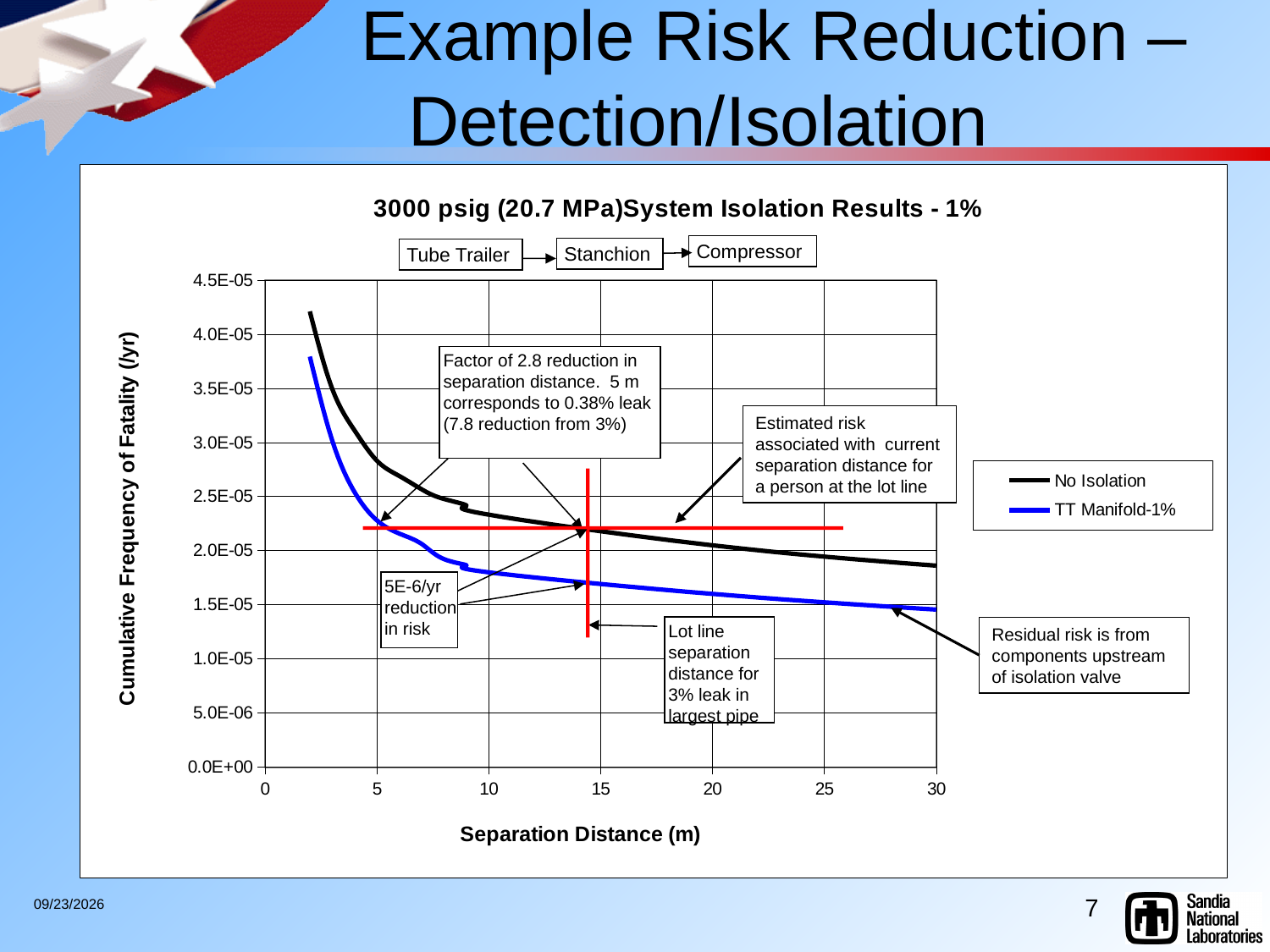
At a separation distance of 15 m, which series has the higher cumulative frequency of fatality, No Isolation or TT Manifold-1%? No Isolation Which series lies below the other across the whole plotted range? TT Manifold-1% How many series does the chart legend list? 2 What is the label of the x axis? Separation Distance (m) At a separation distance of 30 m, is the value for No Isolation greater or less than 2.0E-05? less At a separation distance of 30 m, is the value for TT Manifold-1% greater or less than 2.0E-05? less At a separation distance of 5 m, is the value for TT Manifold-1% greater or less than 2.0E-05? greater What kind of chart is shown on the slide? line chart Does the TT Manifold-1% curve rise or fall as separation distance increases? fall What is the title of the chart? 3000 psig (20.7 MPa)System Isolation Results - 1% Does the No Isolation curve rise or fall as separation distance increases? fall